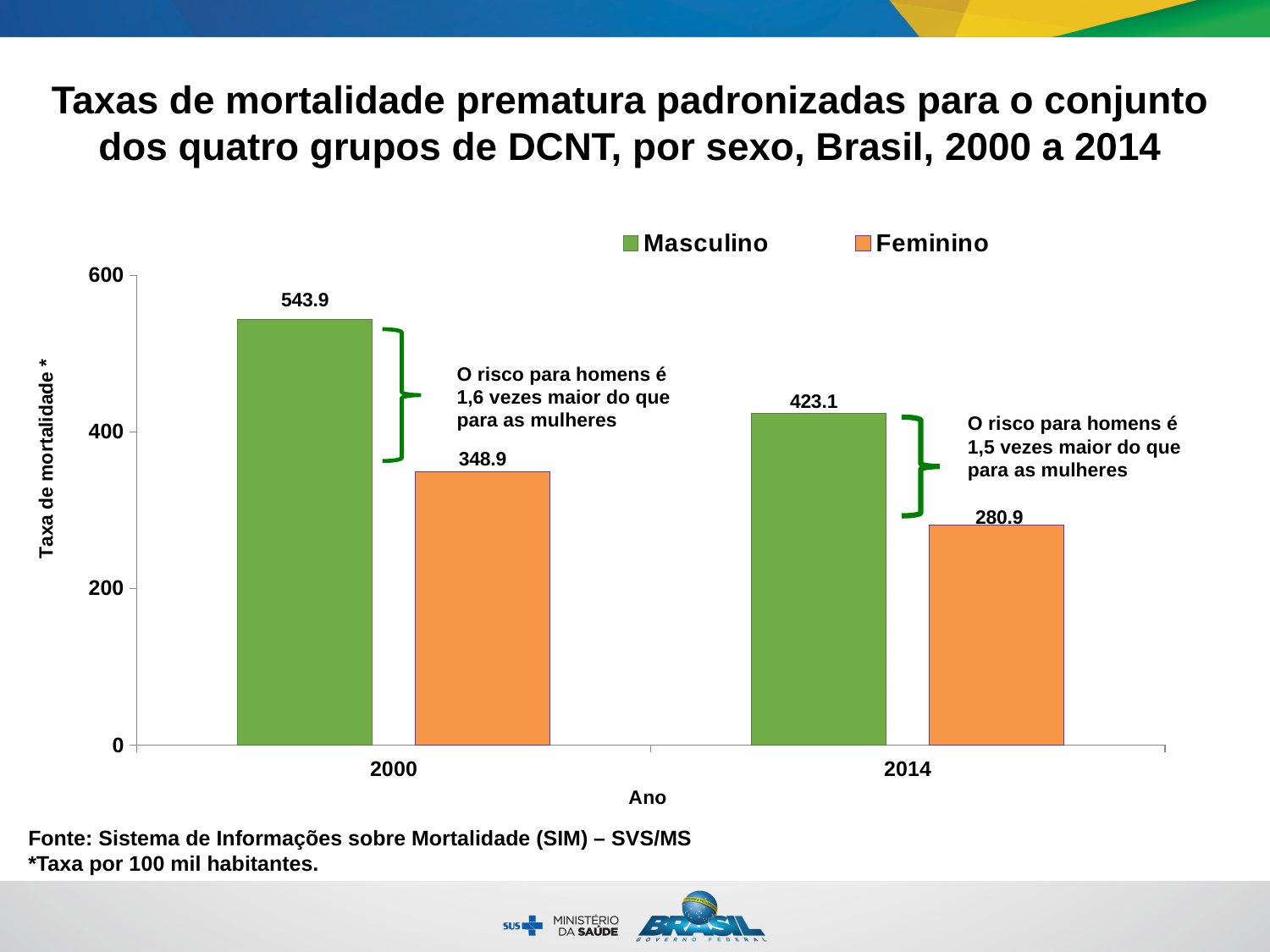
What is the Masculino mortality rate for 2000? 543.9 How many series does the legend list? 2 What is the Masculino mortality rate for 2014? 423.1 What is the Feminino mortality rate for 2014? 280.9 Does the Feminino mortality rate rise or fall from 2000 to 2014? Fall Which is larger, the Feminino rate in 2000 or the Masculino rate in 2014? Masculino rate in 2014 What is the difference between the Masculino and Feminino rates in 2000? 195.0 What kind of chart is shown? Bar chart Which series and year has the highest mortality rate? Masculino, 2000 What is the Feminino mortality rate for 2000? 348.9 Which series and year has the lowest mortality rate? Feminino, 2014 What is the difference between the Masculino rates in 2000 and 2014? 120.8